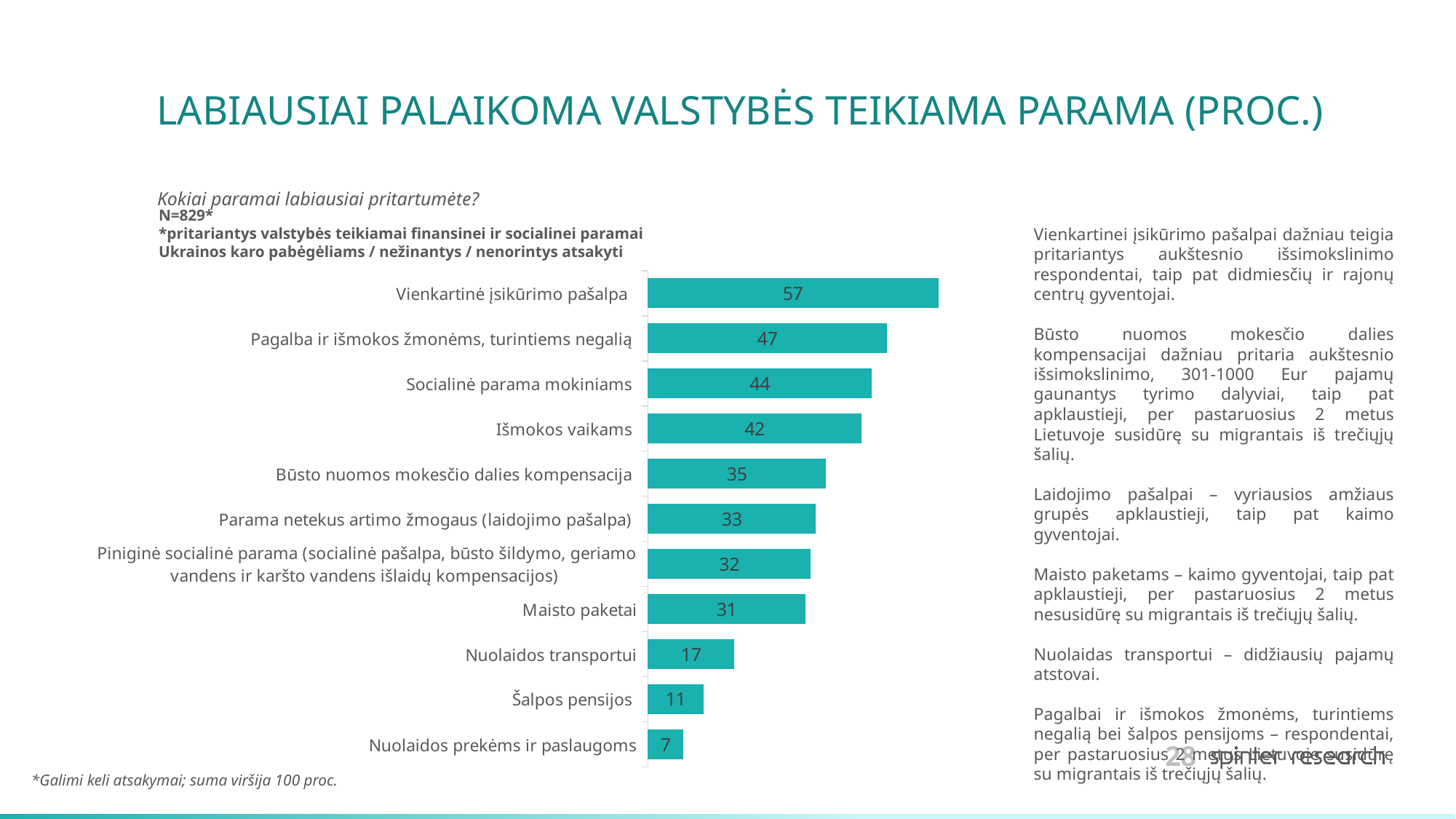
What kind of chart is shown on the slide? Bar chart What is the value for Būsto nuomos mokesčio dalies kompensacija? 35 What is the difference between the values for Maisto paketai and Šalpos pensijos? 20 What colour are the bars in the chart? Teal What is the value for Vienkartinė įsikūrimo pašalpa? 57 What is the difference between the values for Vienkartinė įsikūrimo pašalpa and Pagalba ir išmokos žmonėms, turintiems negalią? 10 Which category has the lowest value? Nuolaidos prekėms ir paslaugoms How many categories are shown in the chart? 11 What is the sample size (N) stated above the chart? N=829* Which category has the highest value? Vienkartinė įsikūrimo pašalpa Which is larger: the value for Socialinė parama mokiniams or the value for Išmokos vaikams? Socialinė parama mokiniams What is the value for Nuolaidos transportui? 17